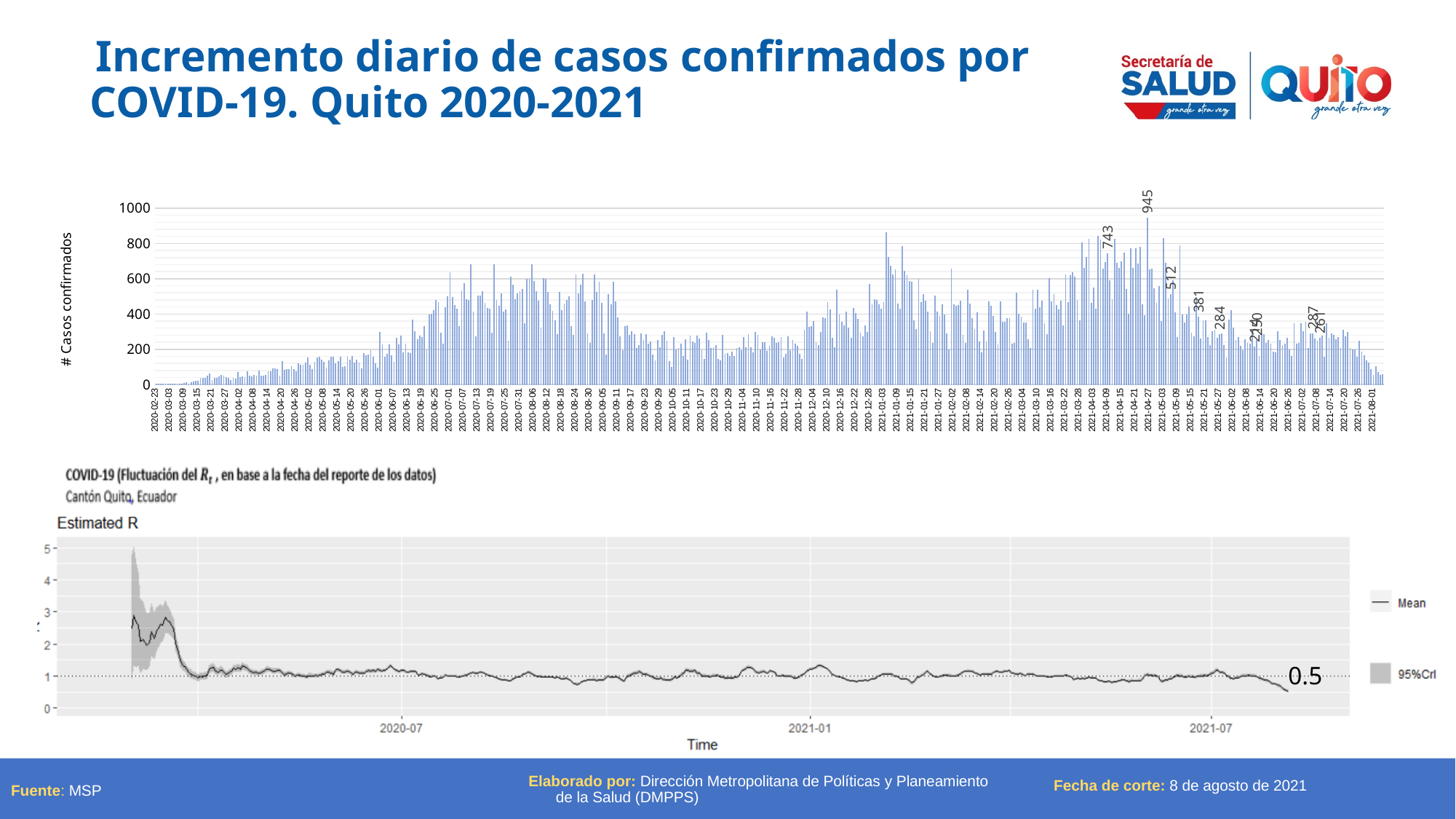
In the bottom chart, does the estimated R rise or fall from the start of the series to its end? fall What is the y-axis label of the top chart? # Casos confirmados What kind of chart is the top chart showing daily confirmed cases? bar chart How many entries does the legend of the bottom chart list? 2 What kind of chart is the bottom chart titled 'COVID-19 (Fluctuación del Rt...)'? line chart What is the x-axis label of the bottom chart? Time In the top chart, what is the difference between the labelled values 381 and 284? 97 In the bottom chart, is the estimated R at 2021-01 greater or less than 2? less In the top chart, which labelled value is larger, 512 or 381? 512 In the bottom chart, what is the labelled value of the estimated R at the end of the series? 0.5 In the top chart, what is the highest labelled daily value of confirmed cases? 945 In the top chart, what is the difference between the labelled values 945 and 743? 202